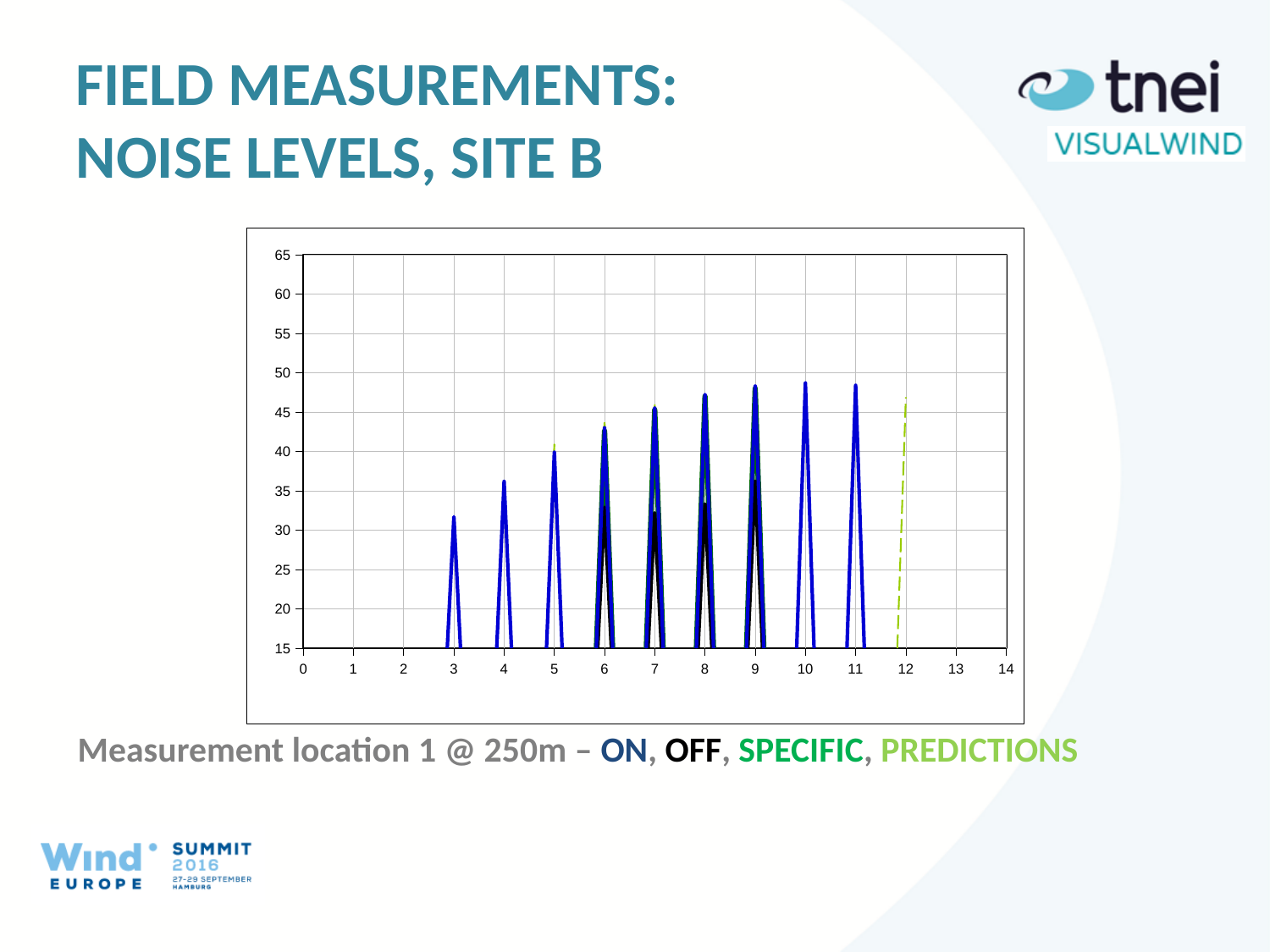
How many blue (ON) peaks are plotted on the chart? 9 Do the blue (ON) peak values generally rise or fall from x = 3 to x = 10? rise What kind of chart is shown on the slide? line chart Is the black (OFF) peak at x = 7 greater or less than 35? less Which blue (ON) peak is higher, the one at x = 3 or the one at x = 4? x = 4 What colour is used for the ON series? blue Is the blue (ON) peak at x = 10 greater or less than 50? less How many series does the caption below the chart list (ON, OFF, SPECIFIC, PREDICTIONS)? 4 Is the blue (ON) peak at x = 3 greater or less than 35? less At which x value is the lowest blue (ON) peak? 3 What is the highest value shown on the y axis? 65